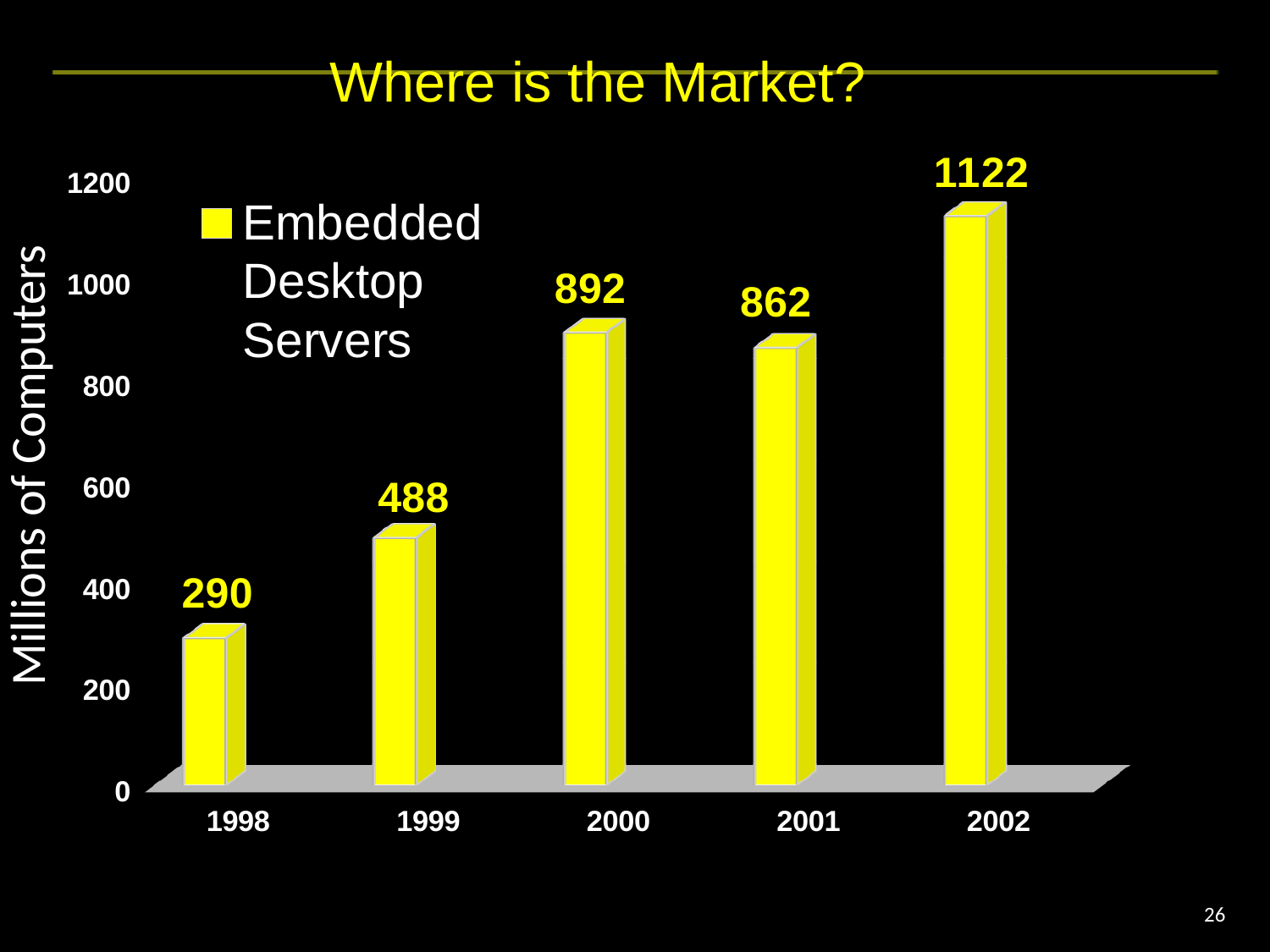
Is the value for 1999 greater or less than 400? greater What is the value for 2002? 1122 What is the value for 1998? 290 Does the value rise or fall from 2000 to 2001? fall Which is larger, the value for 2000 or the value for 2001? 2000 Which year has the highest value? 2002 What is the difference between the values for 2002 and 2001? 260 What kind of chart is shown on the slide? bar chart What is the value for 2000? 892 How many years are shown on the x axis? 5 What is the difference between the values for 1999 and 1998? 198 Which year has the lowest value? 1998